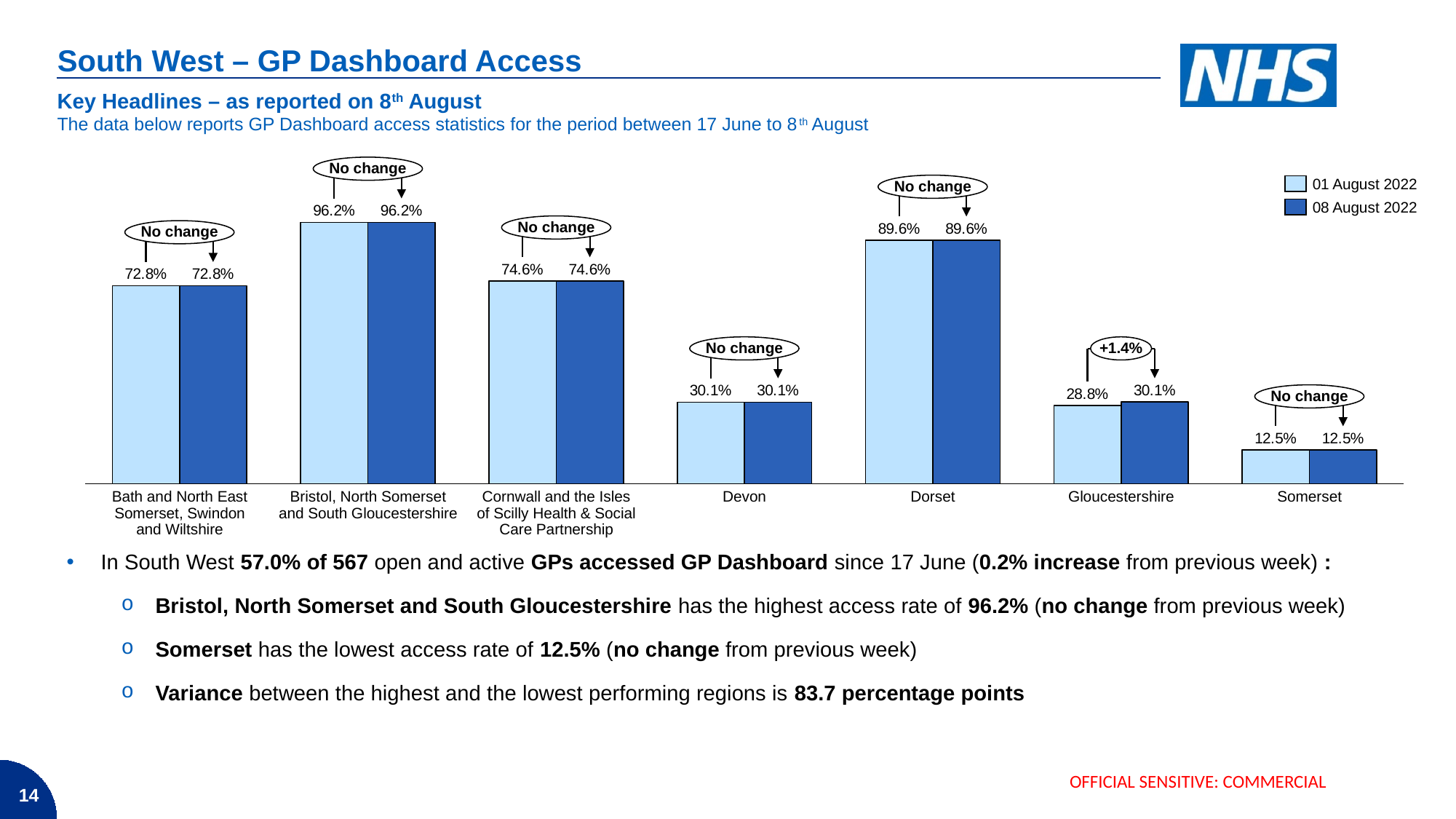
Which is larger on 08 August 2022: Devon or Cornwall and the Isles of Scilly Health & Social Care Partnership? Cornwall and the Isles of Scilly Health & Social Care Partnership Which category is annotated with a change of +1.4%? Gloucestershire What is the value for Somerset on 08 August 2022? 12.5% What kind of chart is shown on the slide? Bar chart What is the difference between the 01 August 2022 and 08 August 2022 values for Gloucestershire? 1.4 percentage points What is the difference between the 08 August 2022 values for Bristol, North Somerset and South Gloucestershire and Somerset? 83.7 percentage points What is the value for Gloucestershire on 01 August 2022? 28.8% Which category has the highest value on 08 August 2022? Bristol, North Somerset and South Gloucestershire How many categories are shown on the x axis? 7 What is the value for Dorset on 08 August 2022? 89.6% How many series does the legend list? 2 Which category has the lowest value on 08 August 2022? Somerset